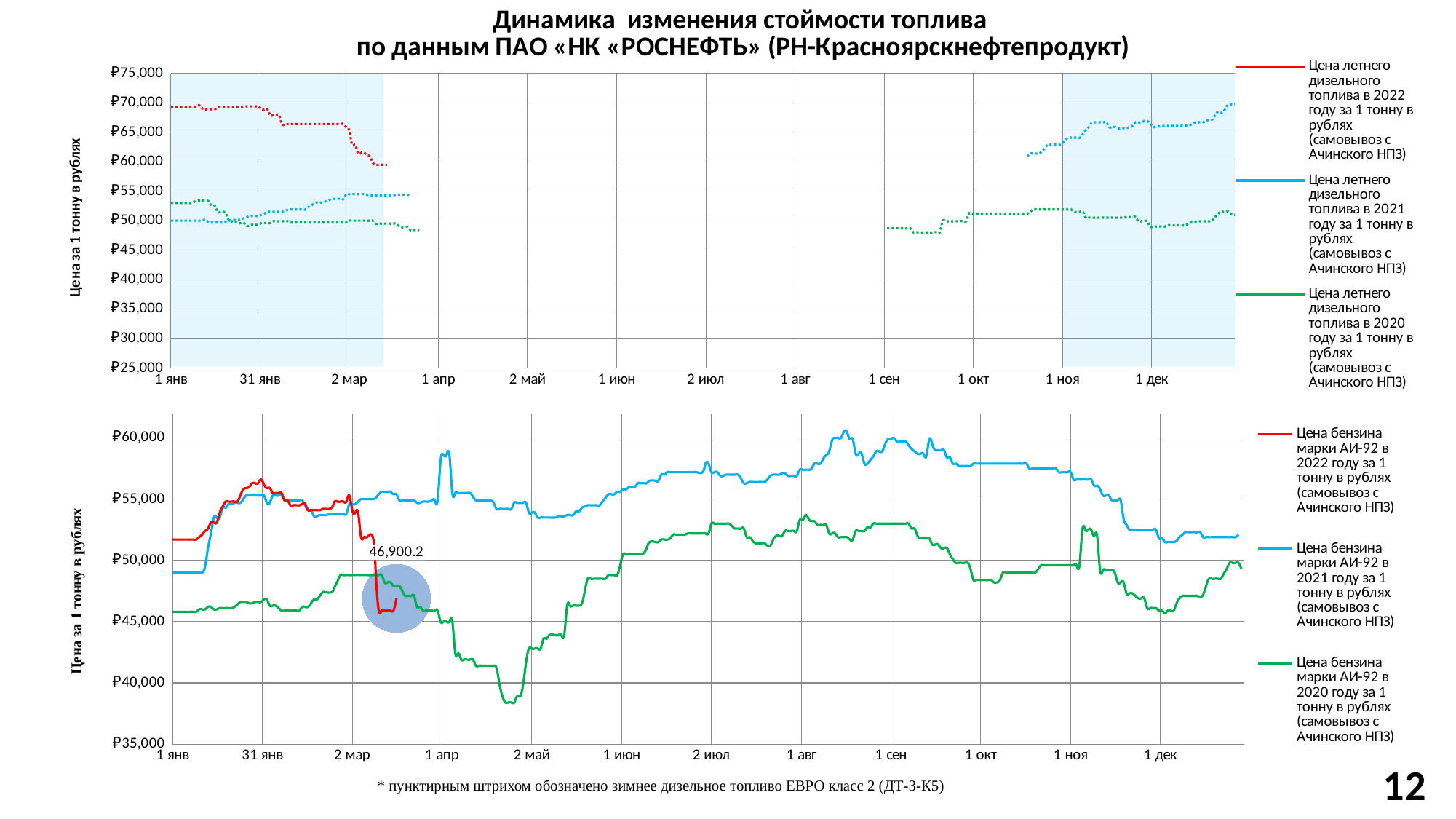
In the top chart (diesel fuel), is the 2021 price on 1 Jan greater or less than 55,000? less In the bottom chart (AI-92 gasoline), on 1 Sep which is higher: the 2021 price or the 2020 price? 2021 price What kind of chart is the top chart on the slide? line chart In the bottom chart (AI-92 gasoline), what value is printed as a data label on the 2022 series? 46,900.2 How many series does the legend of the top chart (diesel fuel prices) list? 3 In the top chart (diesel fuel), on 1 Jan which is higher: the 2022 price or the 2020 price? 2022 price In the bottom chart (AI-92 gasoline), which series reaches the highest value on the chart? 2021 (Цена бензина марки АИ-92 в 2021 году) In the top chart (diesel fuel), is the 2022 price on 1 Jan greater or less than 65,000? greater In the bottom chart (AI-92 gasoline), is the 2021 price on 1 Jan greater or less than 50,000? less How many series does the legend of the bottom chart (AI-92 gasoline prices) list? 3 In the bottom chart (AI-92 gasoline), does the 2022 series rise or fall between 2 Mar and mid-March? fall